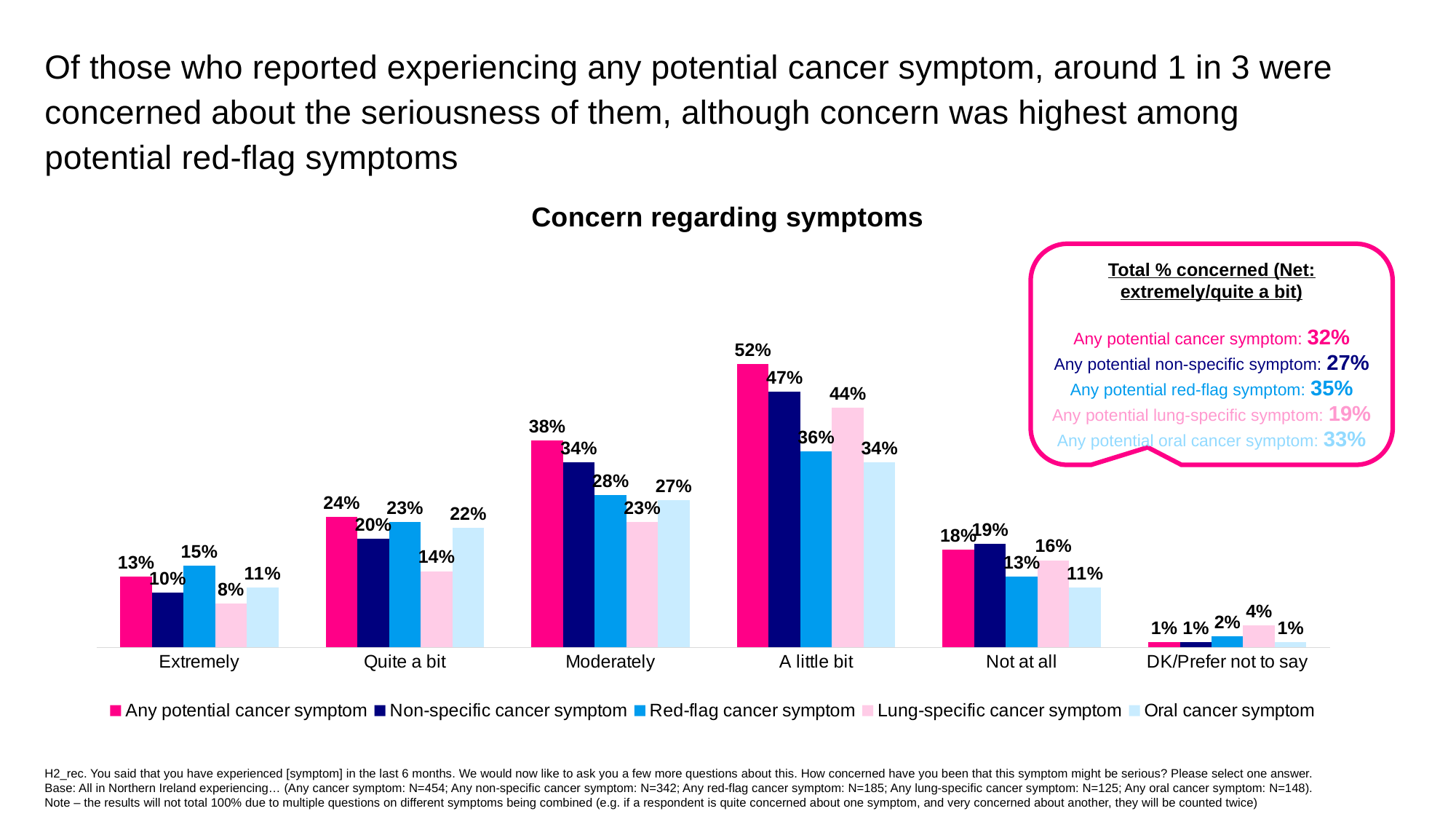
What is the title of the chart? Concern regarding symptoms How many categories are shown on the x axis? 6 What is the value for Oral cancer symptom in the Moderately category? 27% What is the value for Red-flag cancer symptom in the Quite a bit category? 23% What is the difference between Any potential cancer symptom and Non-specific cancer symptom in the Moderately category? 4% What is the value for Lung-specific cancer symptom in the Extremely category? 8% In the Not at all category, which is larger: Lung-specific cancer symptom or Oral cancer symptom? Lung-specific cancer symptom What is the value for Any potential cancer symptom in the A little bit category? 52% Which category has the highest value for Non-specific cancer symptom? A little bit What kind of chart is shown? Bar chart How many series does the legend list? 5 Which category has the lowest value for Lung-specific cancer symptom? DK/Prefer not to say